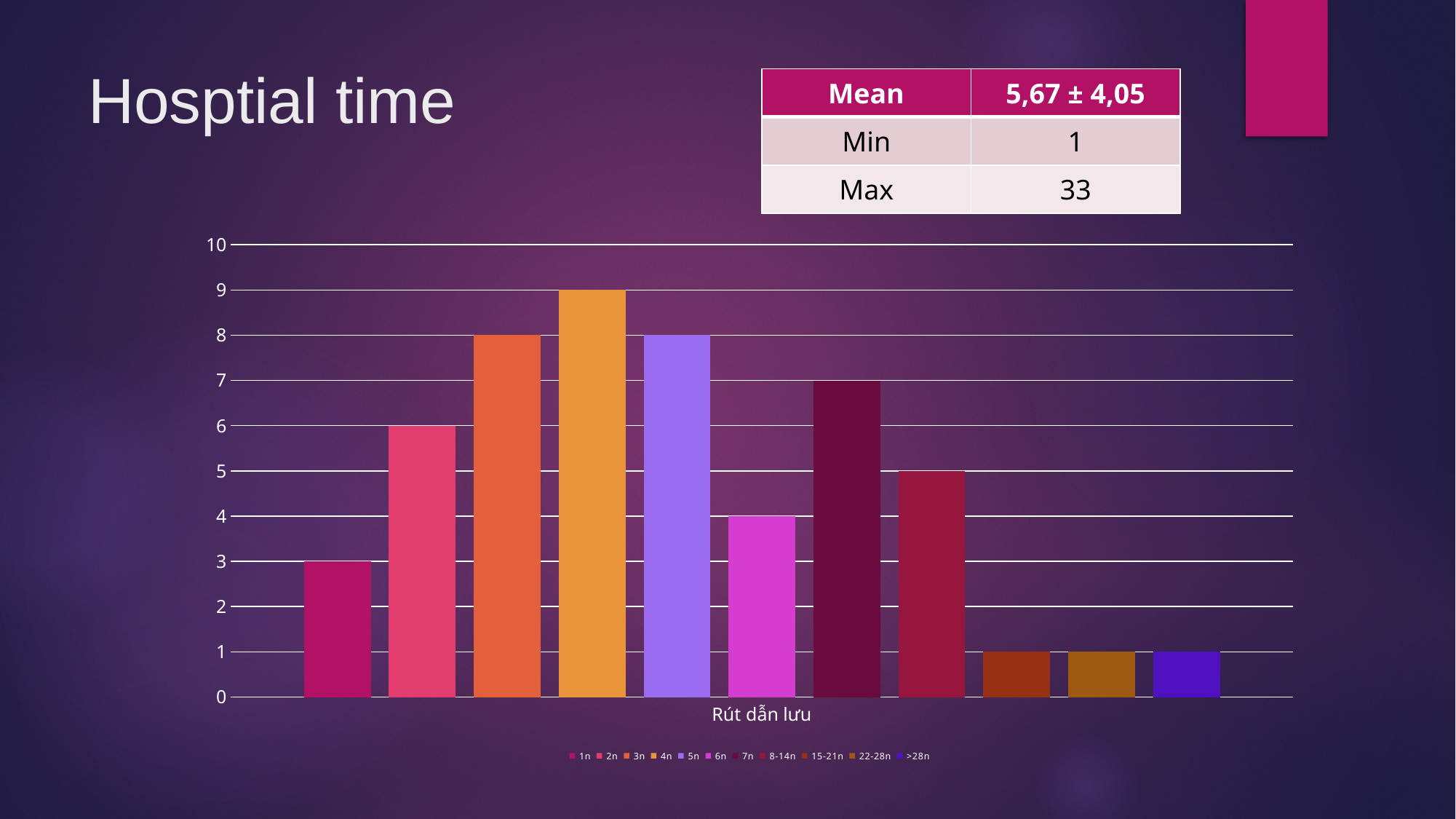
What is the category label shown on the x axis? Rút dẫn lưu Which is larger, the value for 2n or the value for 6n? 2n What is the value for the 4n series? 9 Which series has the highest value? 4n What is the value for the 7n series? 7 What is the difference between the values for 4n and 1n? 6 What is the title of the slide? Hosptial time Is the value for 8-14n greater or less than 4? greater What is the value for the 1n series? 3 What kind of chart is shown on the slide? bar chart How many series does the legend list? 11 What is the value for the >28n series? 1